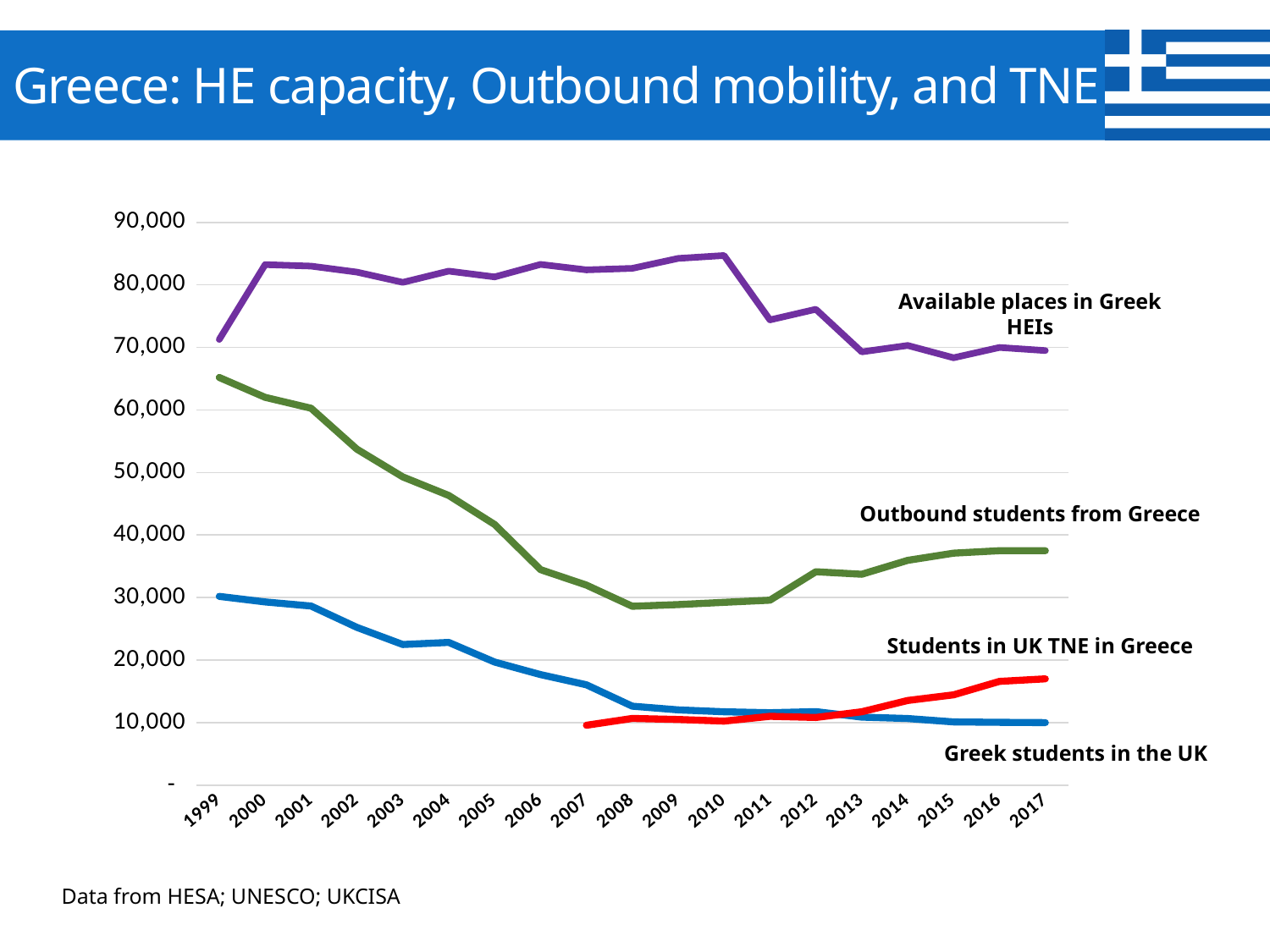
In 2017, which is larger: Students in UK TNE in Greece or Greek students in the UK? Students in UK TNE in Greece How many data series are plotted on the chart? 4 Which series begins in 2007 rather than 1999? Students in UK TNE in Greece Is the value for Available places in Greek HEIs in 2015 greater or less than 70,000? less How many years are shown along the x axis of the chart? 19 Is the value for Students in UK TNE in Greece in 2017 greater or less than 20,000? less What kind of chart is shown on the slide? Line chart In which year does the Available places in Greek HEIs series reach its highest value? 2010 Is the value for Outbound students from Greece in 1999 greater or less than 60,000? greater Which series has the lowest value in 2017? Greek students in the UK Does the Greek students in the UK series rise or fall from 1999 to 2017? Fall